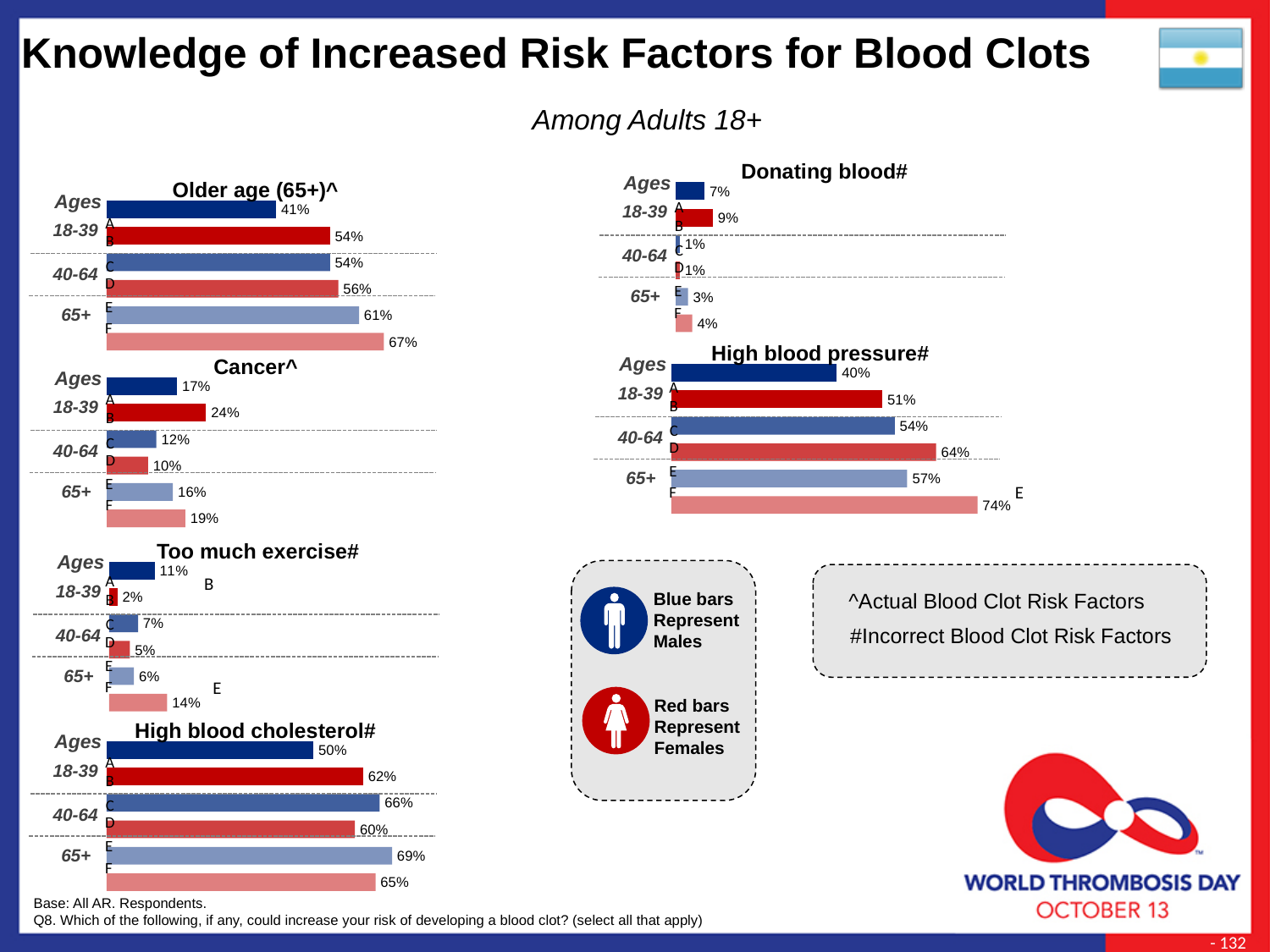
In the 'Too much exercise#' chart, which bar has the lowest value? Females aged 18-39 (2%) In the 'High blood pressure#' chart, what is the value for females aged 40-64? 64% In the 'Older age (65+)^' chart, what is the value for females aged 65+? 67% In the 'Donating blood#' chart, which is larger: the value for males aged 18-39 or females aged 18-39? Females aged 18-39 (9%) In the 'Older age (65+)^' chart, what is the difference between females aged 65+ and males aged 18-39? 26 percentage points In the 'Cancer^' chart, what is the value for males aged 18-39? 17% In the 'High blood cholesterol#' chart, what is the difference between males aged 65+ and males aged 18-39? 19 percentage points In the 'High blood pressure#' chart, which bar has the highest value? Females aged 65+ (74%) How many bars are plotted in the 'Cancer^' chart? 6 What type of chart is used for 'Older age (65+)^'? Bar chart According to the legend, what do the blue bars represent? Males In the 'Donating blood#' chart, what is the value for males aged 65+? 3%